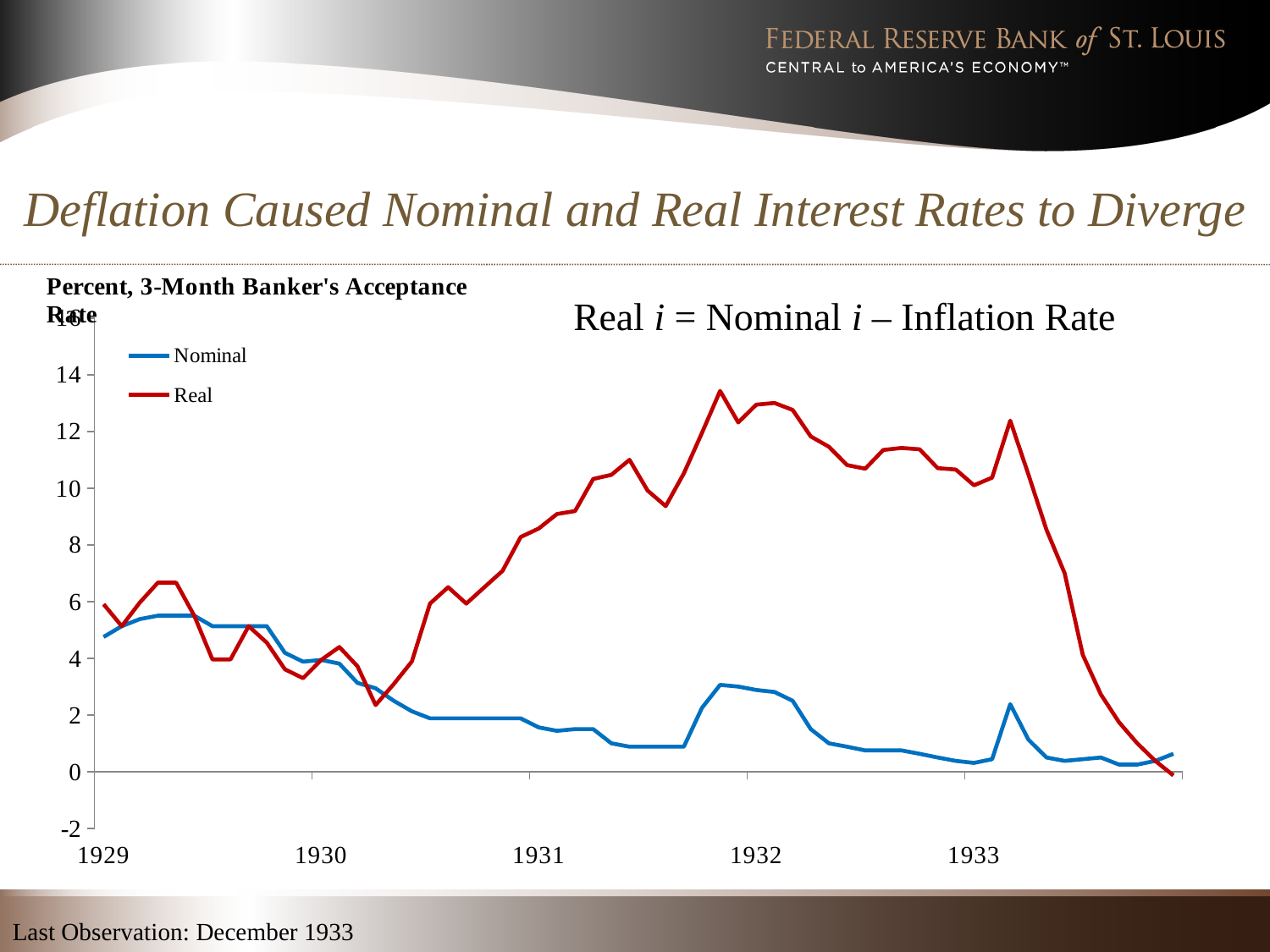
Is the value of the Nominal series at the 1933 tick greater or less than 2? less What is the title of the slide's chart? Deflation Caused Nominal and Real Interest Rates to Diverge Which series reaches the highest value on the chart? Real How many series does the legend list? 2 Does the Nominal series rise or fall from 1929 to 1931? fall At the 1932 tick, which series has the higher value, Nominal or Real? Real Is the value of the Nominal series at the start of 1929 greater or less than 4? greater How many year labels are shown on the x axis? 5 Is the peak value of the Real series in 1932 greater or less than 12? greater What are the two series named in the legend? Nominal and Real What kind of chart is shown on the slide? line chart